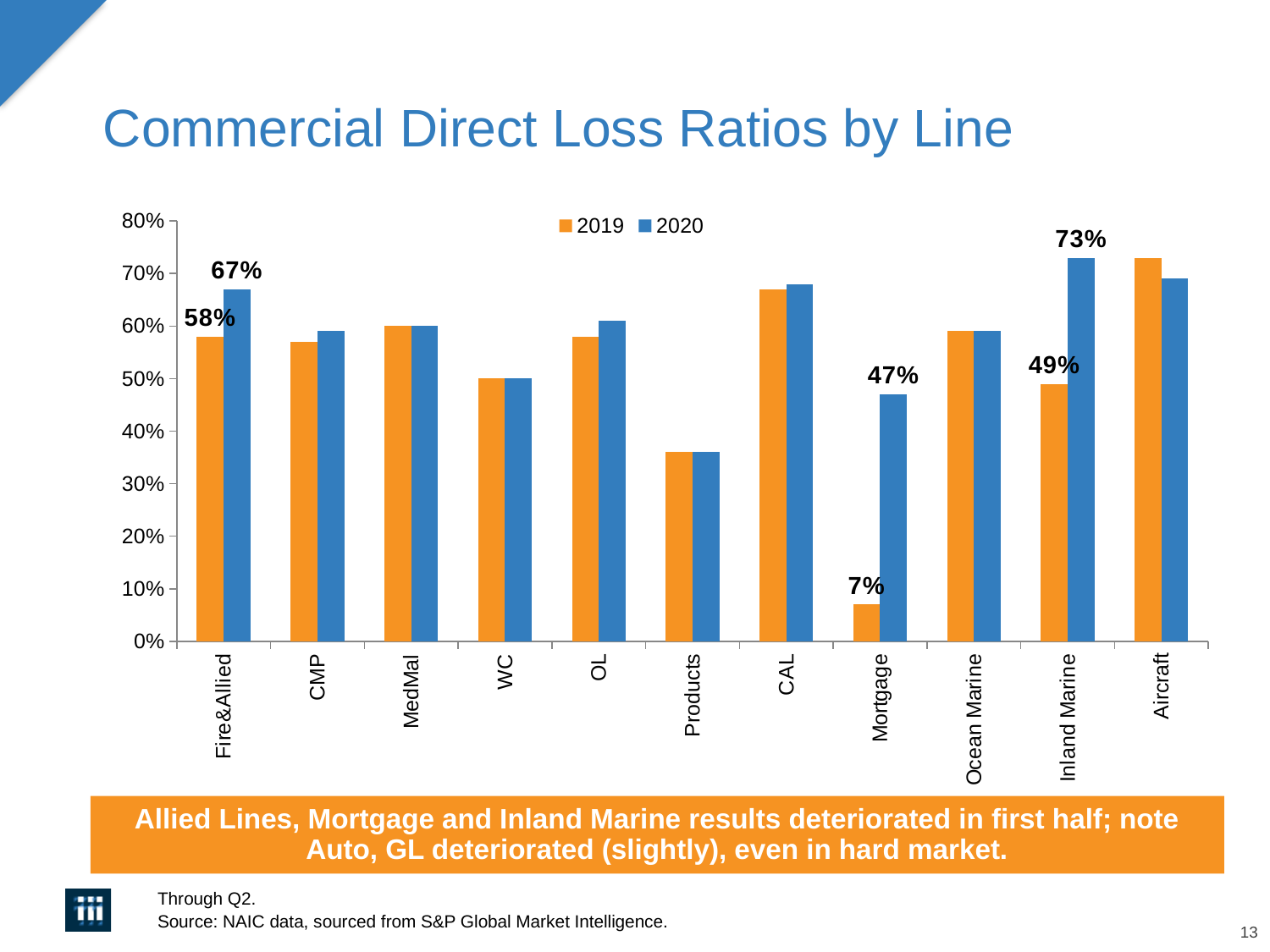
What is the 2019 loss ratio for Fire&Allied? 58% Is the 2019 loss ratio for Products greater or less than 40%? less What kind of chart is shown on the slide? Bar chart Which line has the lowest 2019 loss ratio? Mortgage By how many percentage points did the Fire&Allied loss ratio change from 2019 to 2020? 9 percentage points Which line has the highest 2020 loss ratio? Inland Marine What is the 2019 loss ratio for Mortgage? 7% What is the 2020 loss ratio for Inland Marine? 73% How many lines of business are shown on the x axis? 11 How many series does the legend list? 2 By how many percentage points did the Mortgage loss ratio change from 2019 to 2020? 40 percentage points What is the 2020 loss ratio for Mortgage? 47%